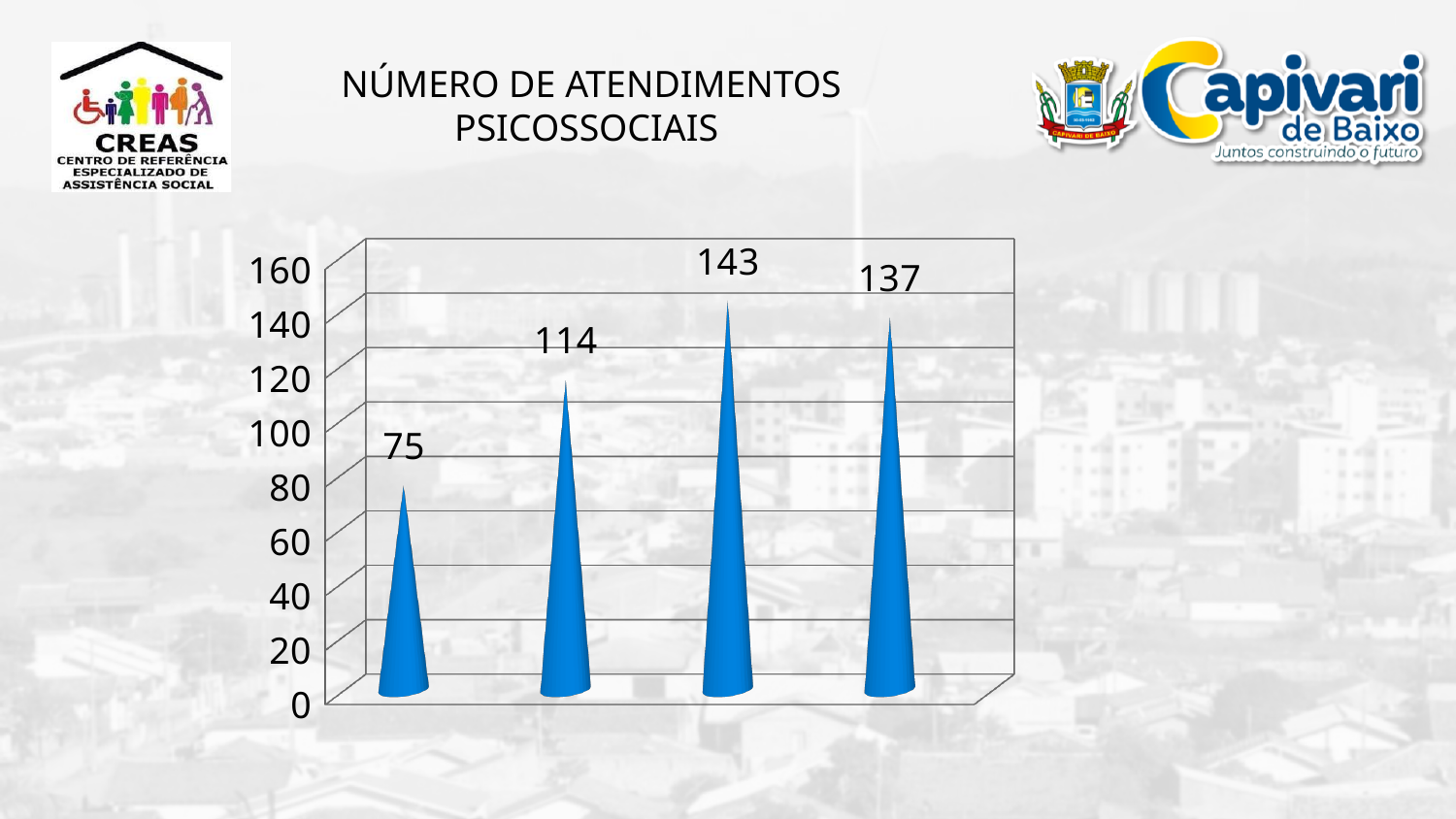
Which bar has the lowest value? The first bar from the left (75) What kind of chart is shown on the slide? Bar chart What is the value shown on the fourth bar from the left? 137 What is the value shown on the first bar from the left? 75 What is the value shown on the third bar from the left? 143 What is the difference between the third bar (143) and the fourth bar (137)? 6 What is the difference between the second bar (114) and the first bar (75)? 39 How many bars are plotted in the chart? 4 Is the value of the second bar from the left greater or less than 100? greater Which bar has the highest value? The third bar from the left (143) Which is larger, the value of the second bar or the value of the fourth bar? The fourth bar (137) What is the title shown above the chart? NÚMERO DE ATENDIMENTOS PSICOSSOCIAIS